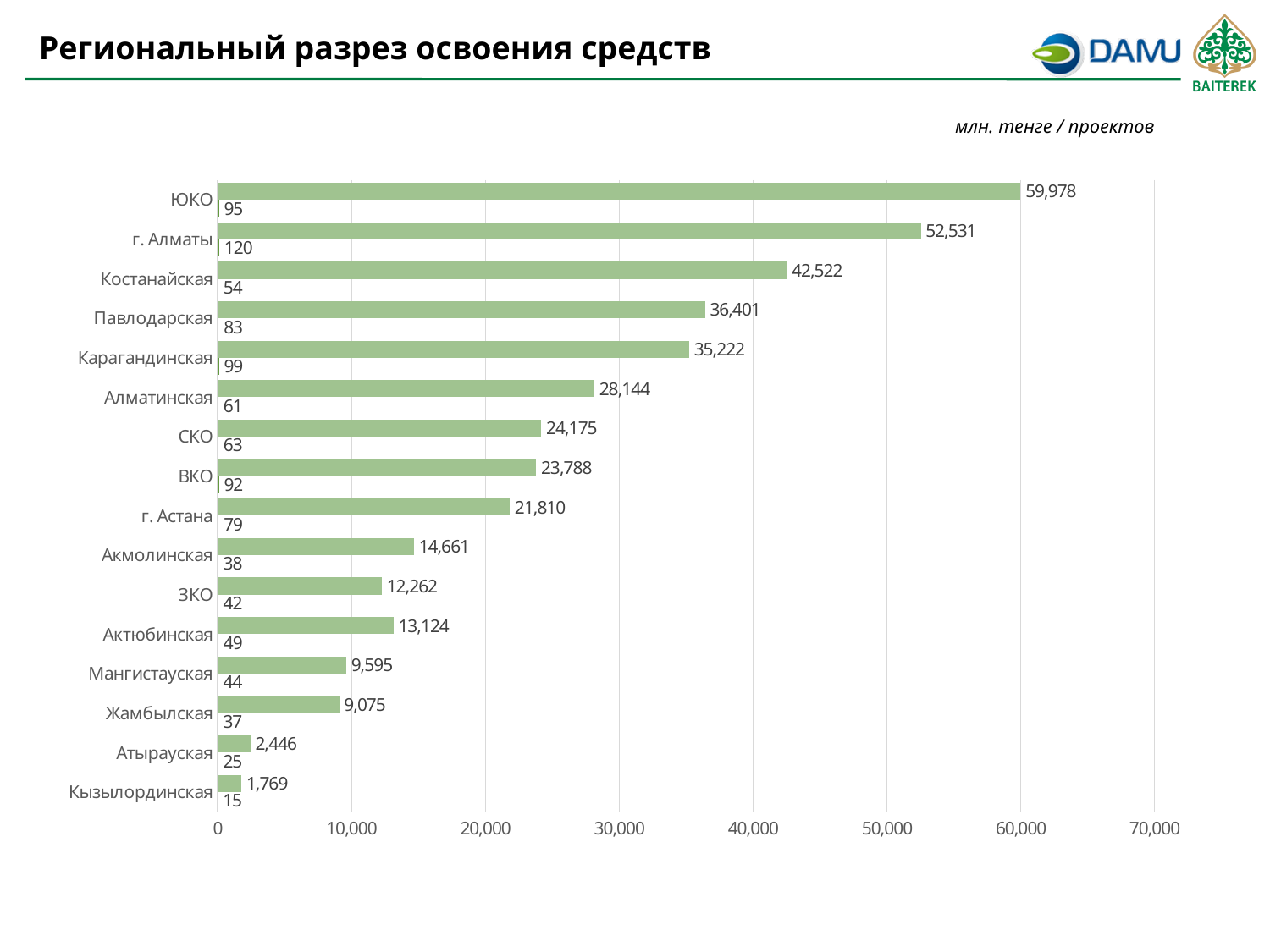
What is the difference in the number of projects between Карагандинская and Алматинская? 38 What is the value in млн. тенге for Костанайская? 42,522 What is the title of the slide? Региональный разрез освоения средств Which region has the highest value in млн. тенге? ЮКО How many regions are shown on the chart? 16 What is the difference in млн. тенге between ЮКО and г. Алматы? 7,447 Is the value in млн. тенге for Павлодарская greater or less than 30,000? greater How many projects are shown for г. Алматы? 120 Which region has the lowest value in млн. тенге? Кызылординская Which has a larger value in млн. тенге, ЗКО or Актюбинская? Актюбинская Which region has the highest number of projects? г. Алматы What kind of chart is shown on the slide? bar chart